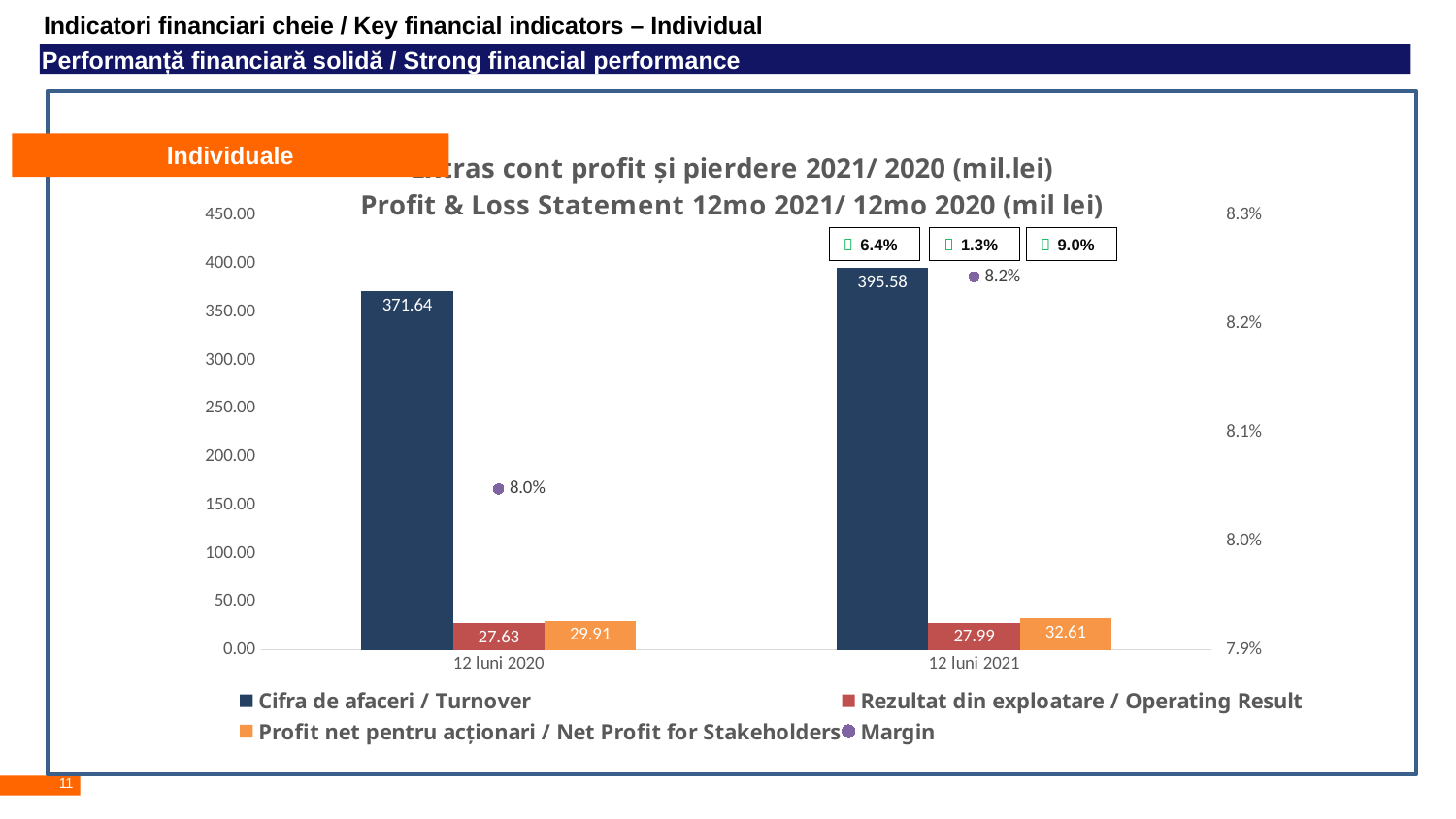
Which series has the highest value in 12 luni 2020? Cifra de afaceri / Turnover How many series does the legend list? 4 Which series has the lowest value in 12 luni 2021 among the bar series? Rezultat din exploatare / Operating Result How many periods (categories) are shown on the x axis? 2 Does the Turnover value rise or fall from 12 luni 2020 to 12 luni 2021? rise What is the difference between the Operating Result values for 12 luni 2021 and 12 luni 2020? 0.36 What is the value of Rezultat din exploatare / Operating Result for 12 luni 2020? 27.63 What is the difference between the Turnover values for 12 luni 2021 and 12 luni 2020? 23.94 What is the Profit net pentru acționari / Net Profit for Stakeholders value for 12 luni 2021? 32.61 Which period has the higher Net Profit for Stakeholders, 12 luni 2020 or 12 luni 2021? 12 luni 2021 What is the Margin value shown for 12 luni 2020? 8.0% What is the value of Cifra de afaceri / Turnover for 12 luni 2021? 395.58